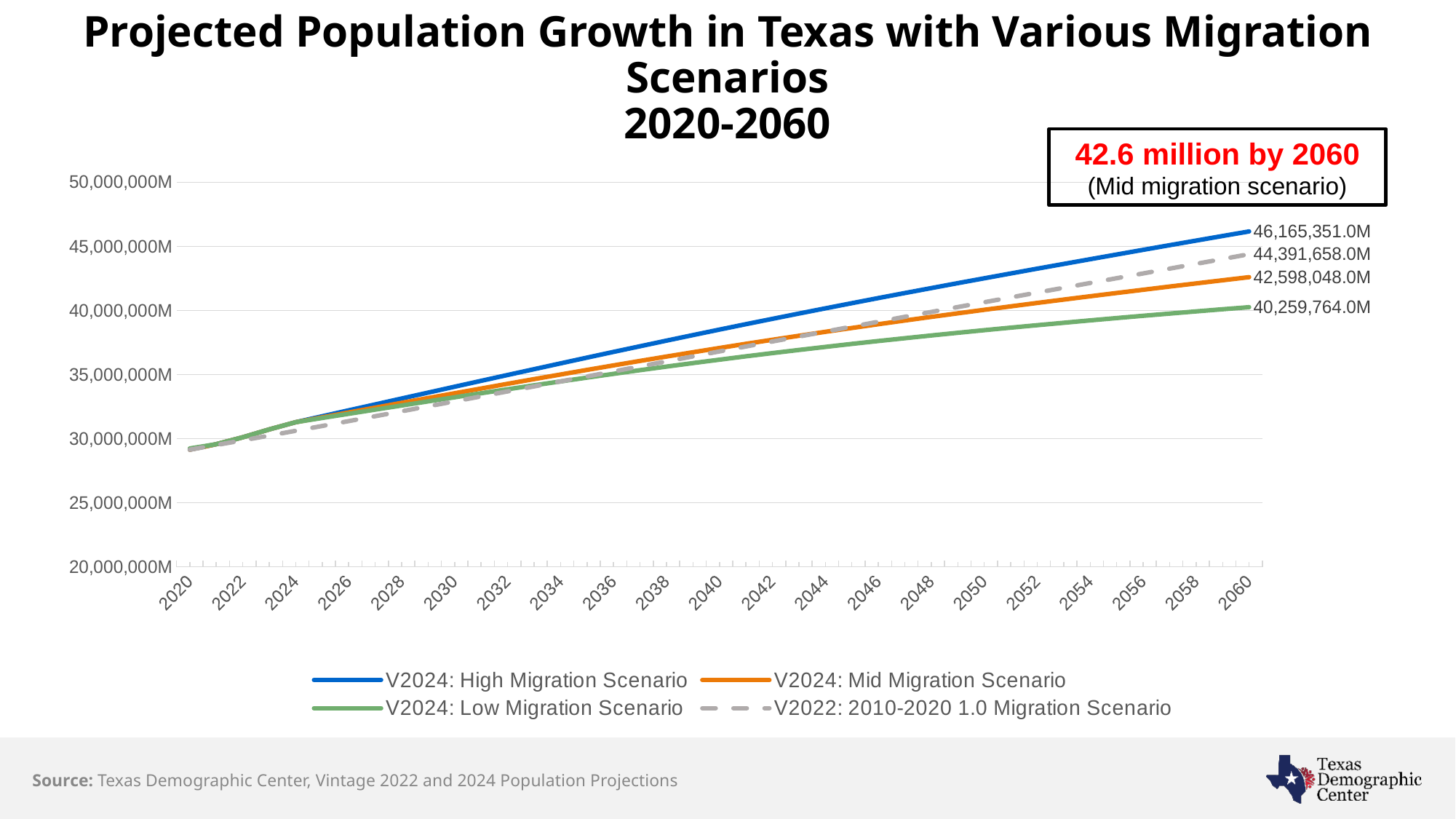
How many series does the legend list? 4 What type of chart is shown on the slide? Line chart What is the projected 2060 population under the V2024 Low Migration Scenario? 40,259,764.0M What is the difference between the 2060 projections of the V2024 High Migration Scenario and the V2024 Low Migration Scenario? 5,905,587.0M Is the value for the V2024 Mid Migration Scenario in 2040 greater or less than 40,000,000M? less What is the projected 2060 population under the V2024 High Migration Scenario? 46,165,351.0M Which scenario has the lowest projected population in 2060? V2024: Low Migration Scenario What is the projected 2060 population under the V2024 Mid Migration Scenario? 42,598,048.0M In 2060, which is larger: the V2022: 2010-2020 1.0 Migration Scenario projection or the V2024 Mid Migration Scenario projection? V2022: 2010-2020 1.0 Migration Scenario Which scenario has the highest projected population in 2060? V2024: High Migration Scenario What is the projected 2060 population under the V2022: 2010-2020 1.0 Migration Scenario? 44,391,658.0M Do the projected population values rise or fall from 2020 to 2060? Rise